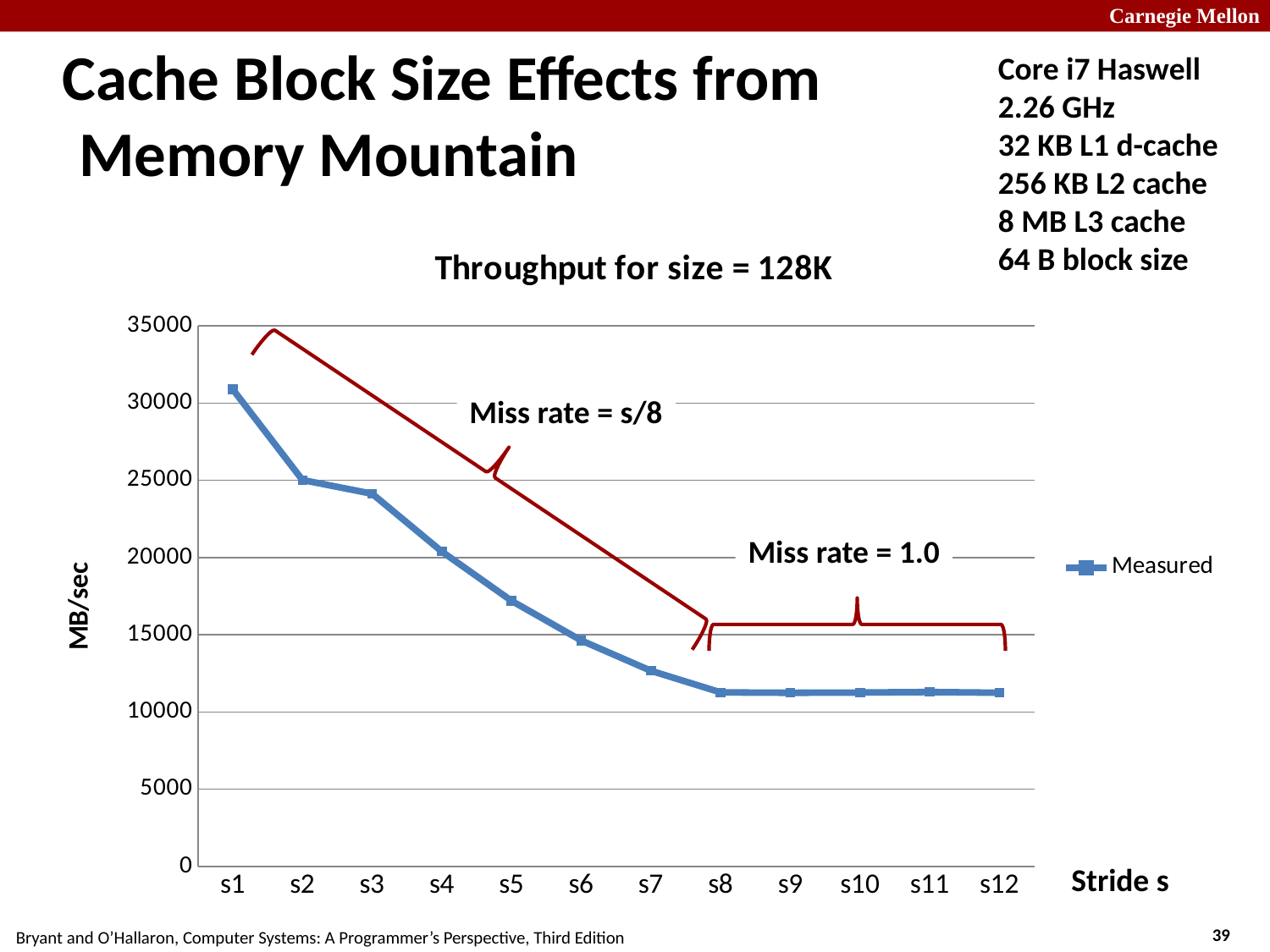
What kind of chart is shown on the slide? line chart What is the title of the chart? Throughput for size = 128K Is the measured throughput for s5 greater or less than 20000 MB/sec? less Which has the larger measured throughput, s3 or s7? s3 What is the name of the series shown in the legend? Measured How many stride values are plotted along the x axis? 12 How many series does the legend list? 1 Is the measured throughput for s1 greater or less than 25000 MB/sec? greater Which stride has the highest measured throughput? s1 Is the measured throughput for s7 greater or less than 15000 MB/sec? less Do the measured throughput values rise or fall as the stride increases from s1 to s8? fall